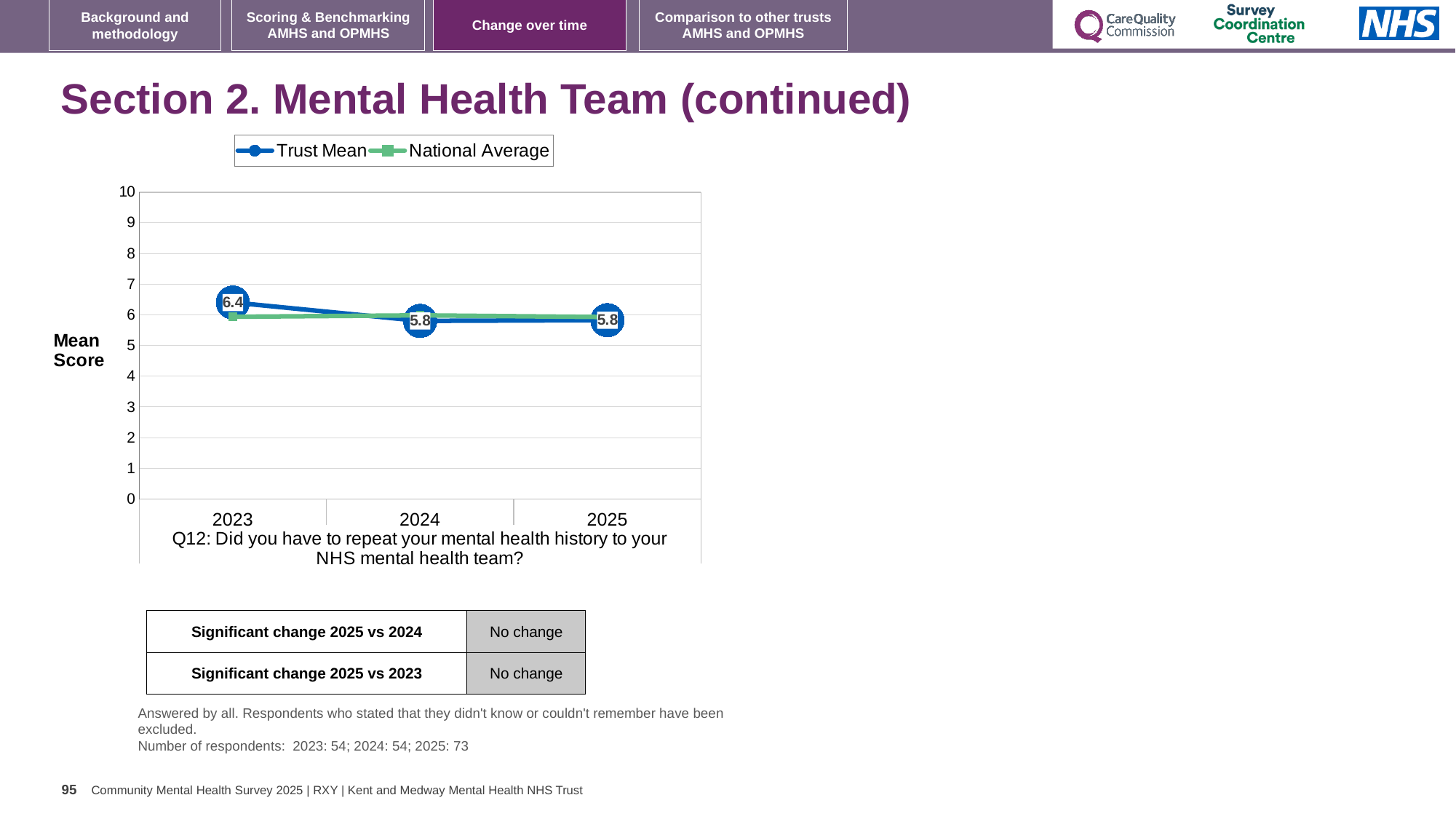
What is the Trust Mean value for 2024? 5.8 What is the label on the y axis of the chart? Mean Score How many series does the legend list? 2 Which is larger in 2023, the Trust Mean or the National Average? Trust Mean What is the Trust Mean value for 2025? 5.8 What is the Trust Mean value for 2023? 6.4 What is the difference between the Trust Mean in 2023 and in 2024? 0.6 Does the Trust Mean rise or fall from 2023 to 2025? fall What kind of chart is shown on the slide? line chart Is the National Average value for 2024 greater or less than 5? greater In which year is the Trust Mean highest? 2023 How many years are plotted on the x axis? 3